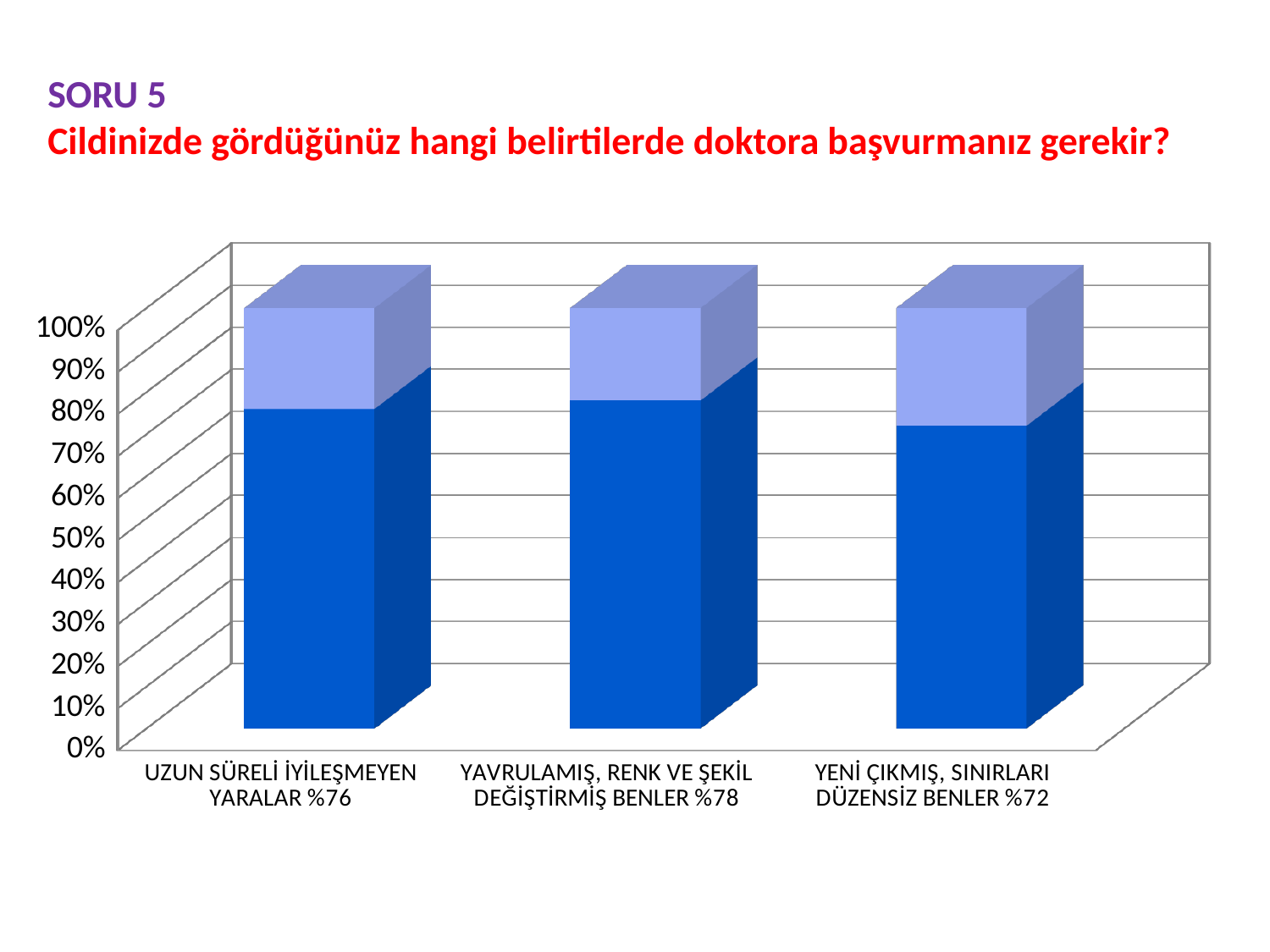
Which is larger: the percentage for UZUN SÜRELİ İYİLEŞMEYEN YARALAR or for YENİ ÇIKMIŞ, SINIRLARI DÜZENSİZ BENLER? UZUN SÜRELİ İYİLEŞMEYEN YARALAR What percentage is shown for the category UZUN SÜRELİ İYİLEŞMEYEN YARALAR? %76 What percentage is shown for the category YAVRULAMIŞ, RENK VE ŞEKİL DEĞİŞTİRMİŞ BENLER? %78 Is the dark blue portion of the bar for YENİ ÇIKMIŞ, SINIRLARI DÜZENSİZ BENLER greater or less than 60%? greater How many categories are shown on the x axis? 3 What percentage is shown for the category YENİ ÇIKMIŞ, SINIRLARI DÜZENSİZ BENLER? %72 What is the total height of each stacked bar? 100% Which category has the highest percentage? YAVRULAMIŞ, RENK VE ŞEKİL DEĞİŞTİRMİŞ BENLER What is the difference in percentage points between YAVRULAMIŞ, RENK VE ŞEKİL DEĞİŞTİRMİŞ BENLER and YENİ ÇIKMIŞ, SINIRLARI DÜZENSİZ BENLER? 6 What question is written in red at the top of the slide? Cildinizde gördüğünüz hangi belirtilerde doktora başvurmanız gerekir? Which category has the lowest percentage? YENİ ÇIKMIŞ, SINIRLARI DÜZENSİZ BENLER What kind of chart is shown on the slide? bar chart